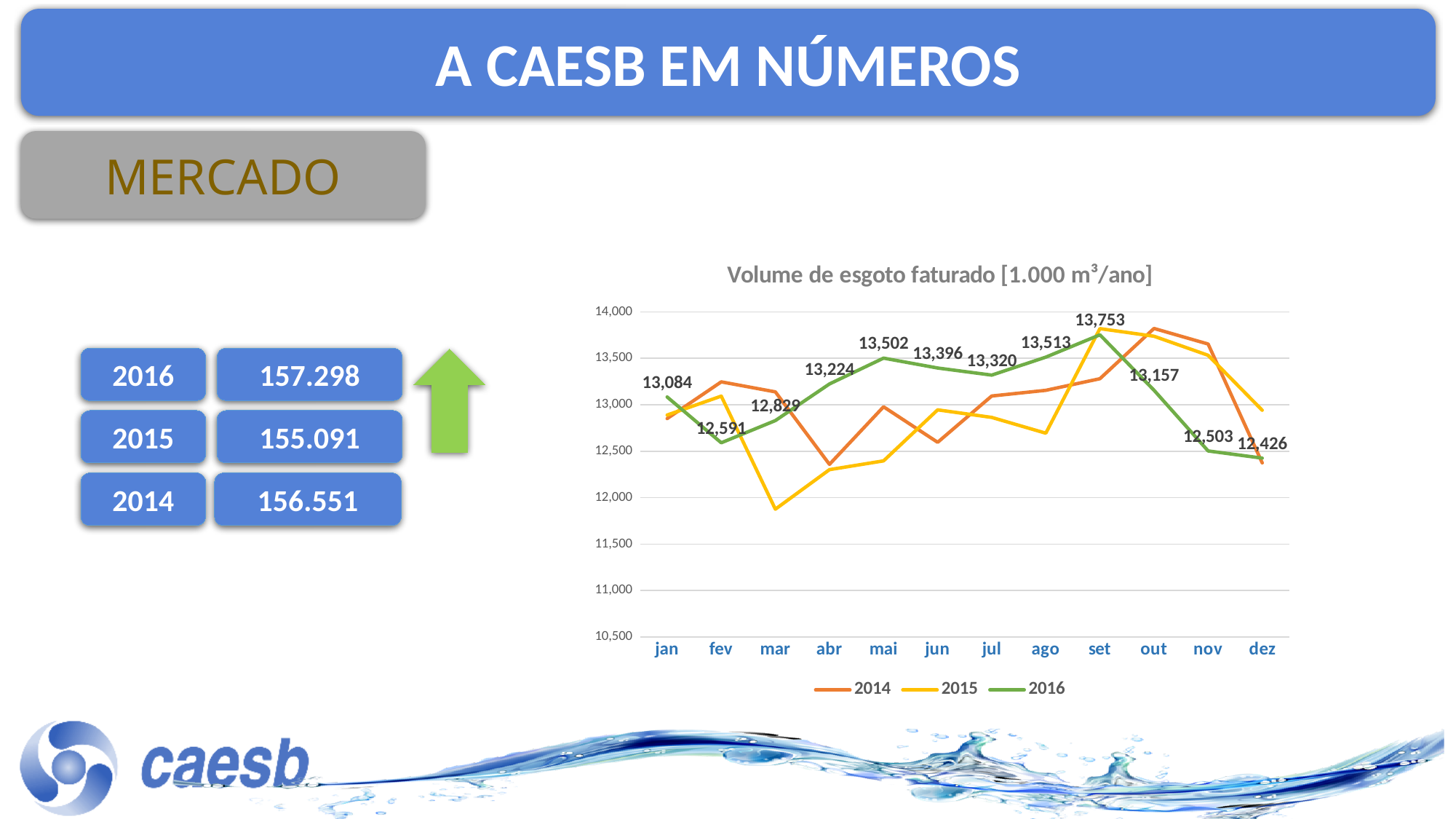
How many months are shown on the x axis of the chart? 12 How many series does the chart legend list? 3 What is the value for 2016 in set (September)? 13,753 Which is larger for 2016: the value in mai or the value in jul? mai What is the value for 2016 in dez? 12,426 What is the value for 2016 in jan? 13,084 What is the title of the chart? Volume de esgoto faturado [1.000 m³/ano] Is the 2015 value for mar greater or less than 12,000? less What type of chart is shown on the slide? line chart In which month does the 2016 series reach its highest value? set In which month does the 2016 series reach its lowest value? dez What is the difference between the 2016 values for set and dez? 1,327